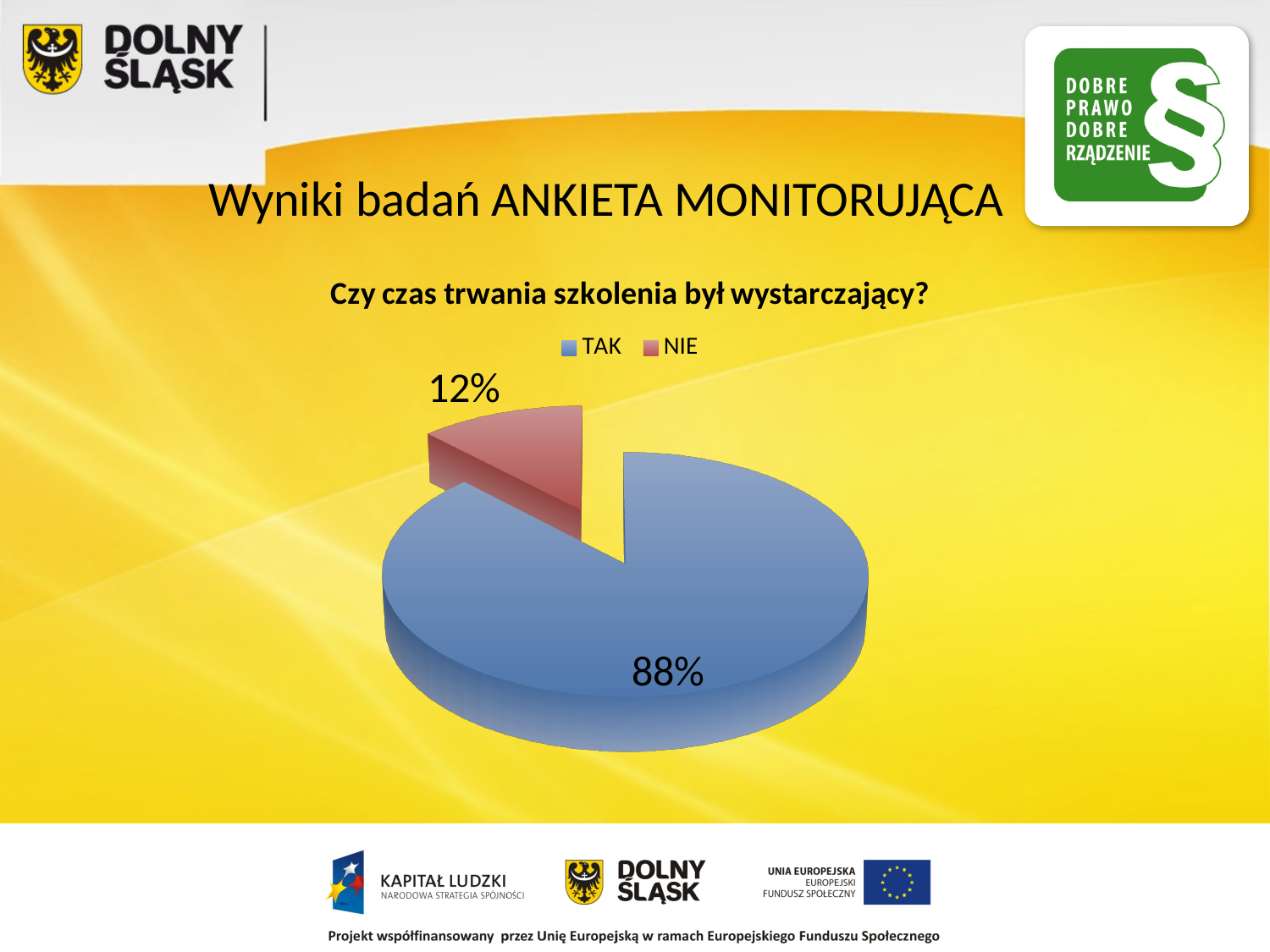
What is the title of the chart? Czy czas trwania szkolenia był wystarczający? What type of chart is shown on the slide? pie chart What is the difference in percentage points between the TAK and NIE slices? 76 Which category has the smallest share of the pie? NIE What colour is the TAK slice? blue How many slices does the pie chart have? 2 Which category has the largest share of the pie? TAK Which is larger, the TAK slice or the NIE slice? TAK What percentage of the pie is labelled TAK? 88% What percentage of the pie is labelled NIE? 12% How many entries does the legend list? 2 What share of the pie does the NIE slice represent? 12%